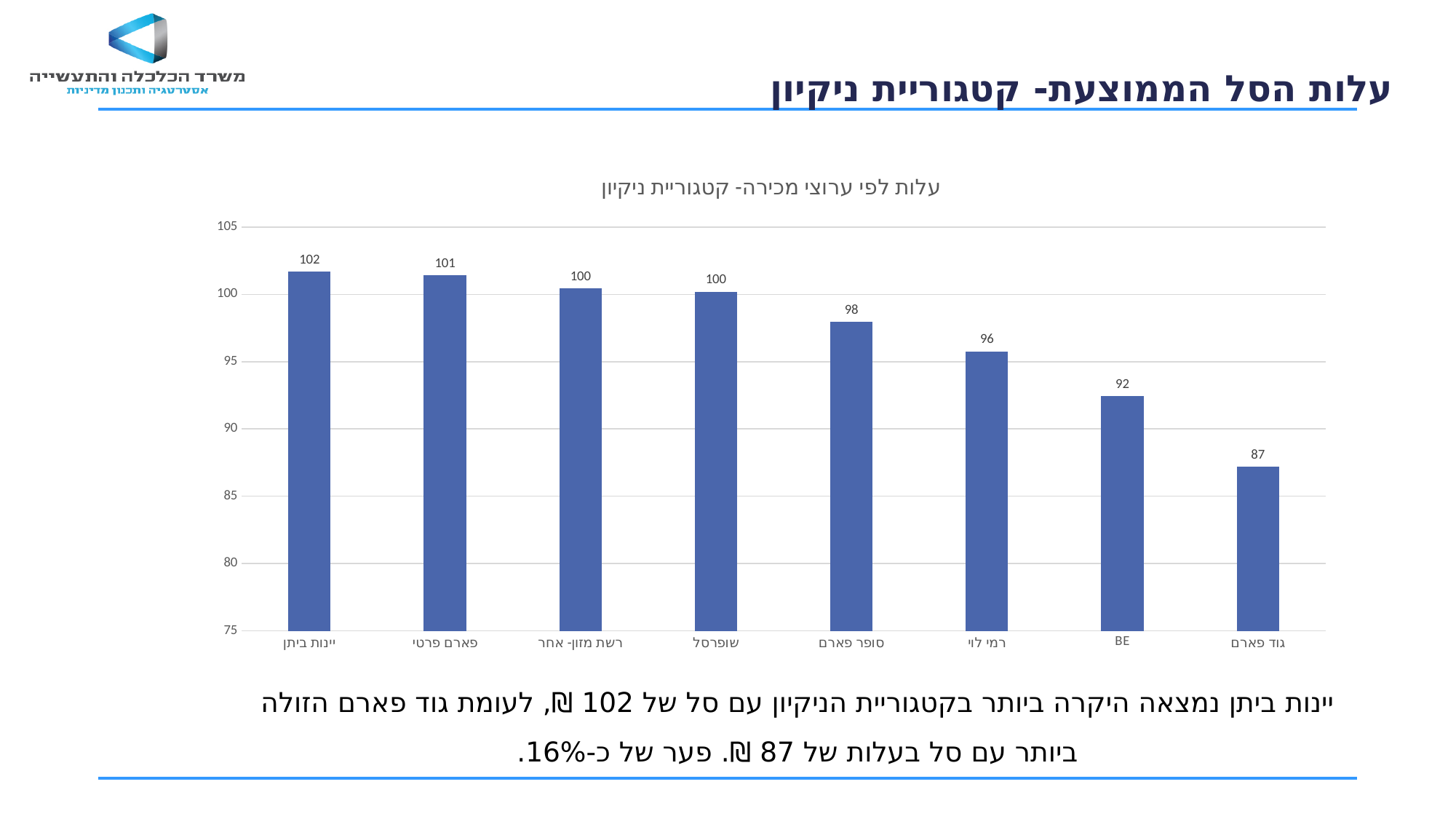
Which category has the lowest value? גוד פארם What kind of chart is shown on the slide? bar chart What is the value for רמי לוי? 96 Which category has the highest value? יינות ביתן What is the value for יינות ביתן? 102 What is the value for BE? 92 What is the difference between the values for יינות ביתן and גוד פארם? 15 What is the title of the chart? עלות לפי ערוצי מכירה- קטגוריית ניקיון How many categories are shown in the chart? 8 Is the value for גוד פארם greater or less than 90? less Which is larger, the value for פארם פרטי or the value for BE? פארם פרטי What is the value for סופר פארם? 98